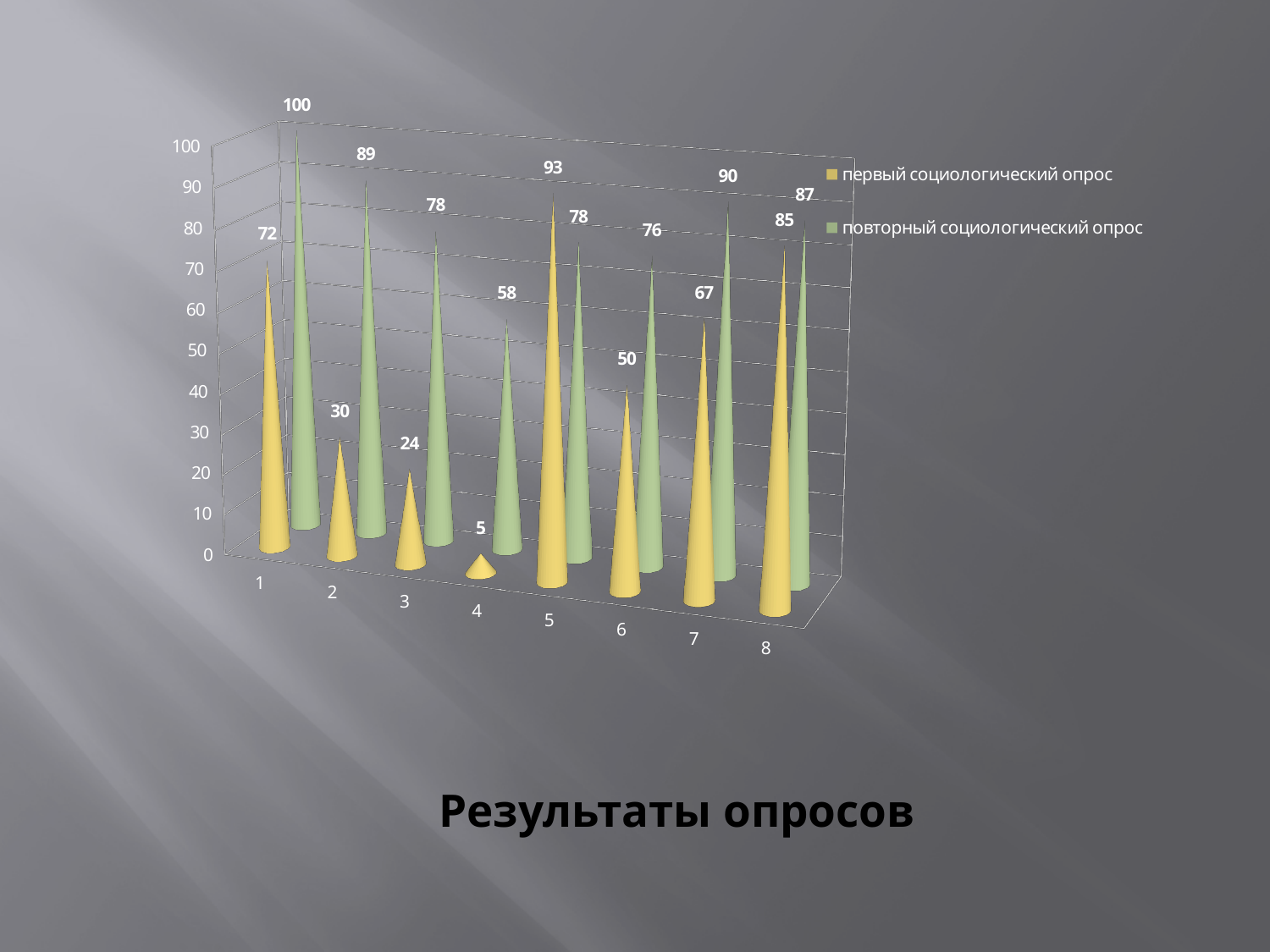
Which is larger for category 5: the value for "первый социологический опрос" or "повторный социологический опрос"? первый социологический опрос What is the value for category 8 in the series "первый социологический опрос"? 85 Which category has the lowest value in the series "первый социологический опрос"? 4 What is the title shown below the chart? Результаты опросов Which category has the highest value in the series "повторный социологический опрос"? 1 What is the difference between the two series for category 2? 59 How many categories are shown on the x axis? 8 What kind of chart is shown on the slide? bar chart What is the value for category 4 in the series "повторный социологический опрос"? 58 How many series does the legend list? 2 Which colour represents the series "повторный социологический опрос"? green What is the value for category 1 in the series "первый социологический опрос"? 72